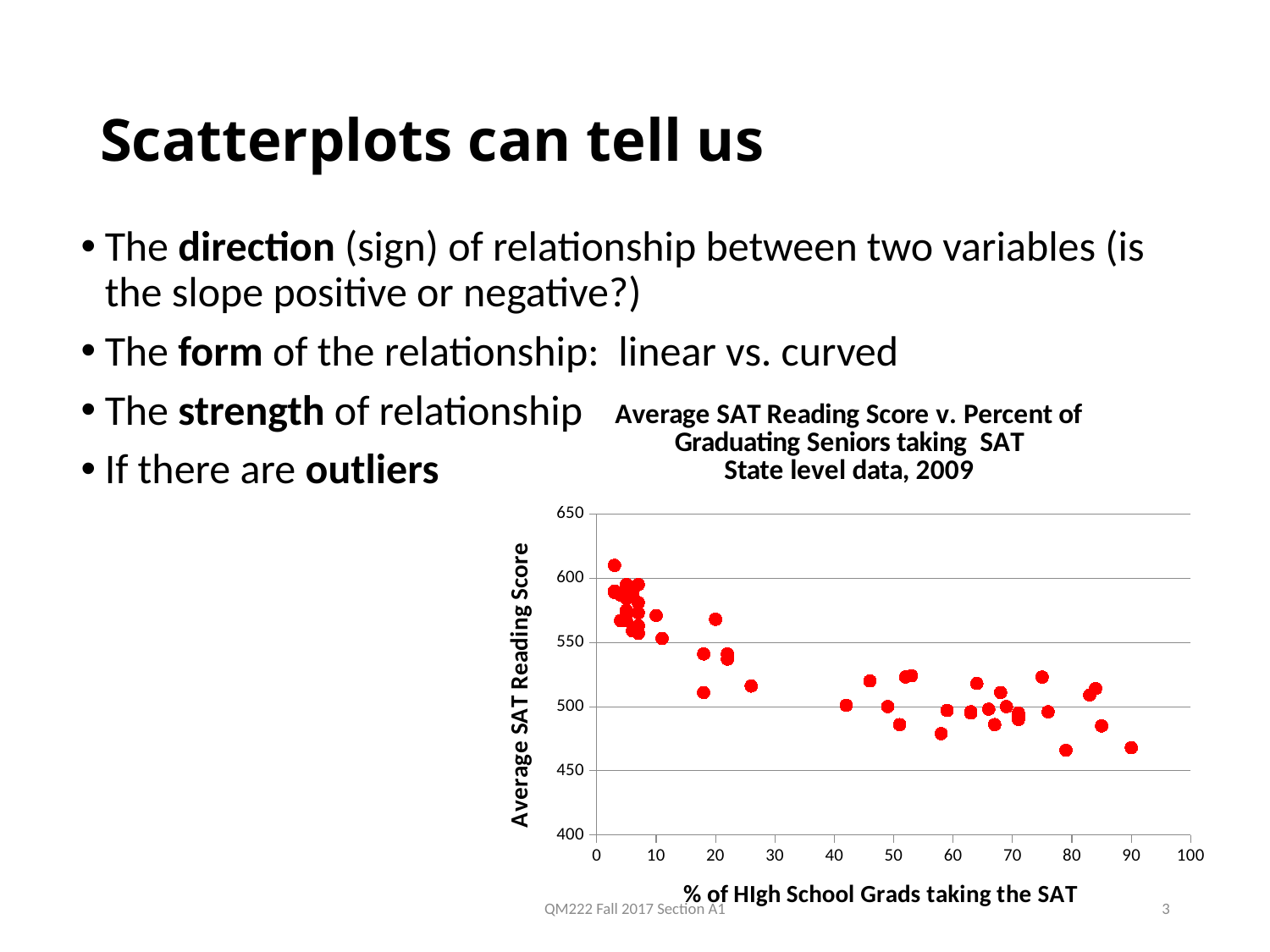
What is the label on the x axis of the chart? % of HIgh School Grads taking the SAT Is the direction of the relationship shown in the scatter plot positive or negative? Negative As the percent of high school grads taking the SAT increases, does the average SAT reading score generally rise or fall? Fall What is the highest value shown on the y axis of the chart? 650 What is the title of the chart? Average SAT Reading Score v. Percent of Graduating Seniors taking SAT State level data, 2009 Are the points with more than 40% of grads taking the SAT all greater or less than 550 in average reading score? less Is the highest average SAT reading score plotted greater or less than 600? greater Is the lowest average SAT reading score plotted greater or less than 450? greater What is the highest value shown on the x axis of the chart? 100 What kind of chart is shown on the slide? Scatter plot